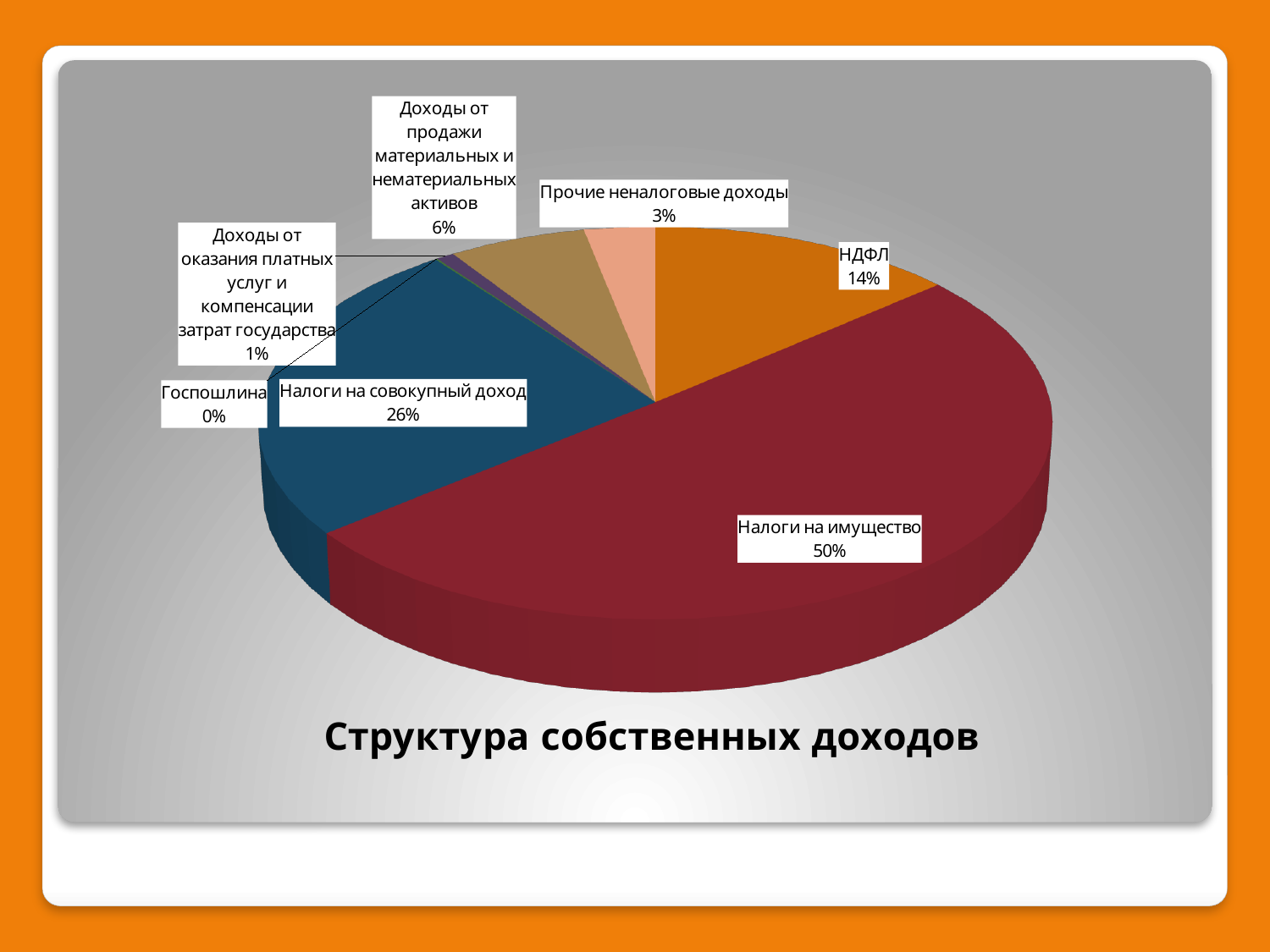
Which category has the smallest slice of the pie? Госпошлина Which is larger, НДФЛ or Прочие неналоговые доходы? НДФЛ What share of the pie does Налоги на имущество have? 50% What is the difference between the shares of Налоги на имущество and Налоги на совокупный доход? 24% How many categories are shown in the pie chart? 7 Which category has the largest slice of the pie? Налоги на имущество What is the value shown for НДФЛ? 14% What is the value shown for Госпошлина? 0% What is the value shown for Доходы от продажи материальных и нематериальных активов? 6% What is the value shown for Прочие неналоговые доходы? 3% What type of chart is shown on the slide? Pie chart What is the value shown for Налоги на совокупный доход? 26%